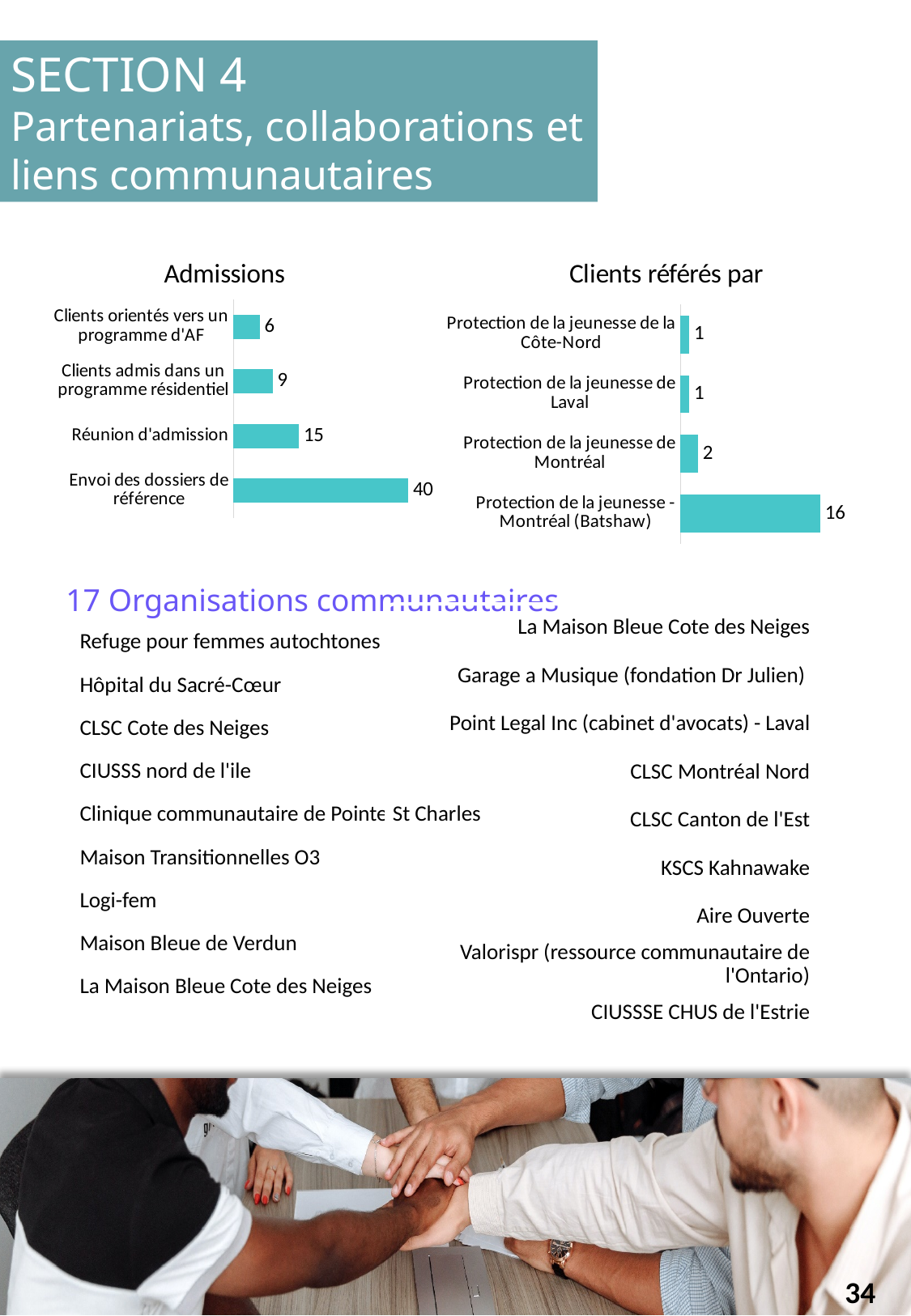
In the "Clients référés par" chart, what is the value for "Protection de la jeunesse de Montréal"? 2 How many categories are shown in the "Clients référés par" chart? 4 What type of chart is the "Clients référés par" chart? Bar chart In the "Admissions" chart, what is the difference between "Envoi des dossiers de référence" and "Réunion d'admission"? 25 In the "Clients référés par" chart, what is the value for "Protection de la jeunesse - Montréal (Batshaw)"? 16 How many categories are shown in the "Admissions" chart? 4 In the "Admissions" chart, which is larger: "Clients admis dans un programme résidentiel" or "Clients orientés vers un programme d'AF"? Clients admis dans un programme résidentiel In the "Admissions" chart, what is the value for "Envoi des dossiers de référence"? 40 In the "Clients référés par" chart, which category has the highest value? Protection de la jeunesse - Montréal (Batshaw) In the "Admissions" chart, which category has the lowest value? Clients orientés vers un programme d'AF In the "Admissions" chart, what is the value for "Réunion d'admission"? 15 In the "Clients référés par" chart, what is the difference between "Protection de la jeunesse - Montréal (Batshaw)" and "Protection de la jeunesse de Montréal"? 14